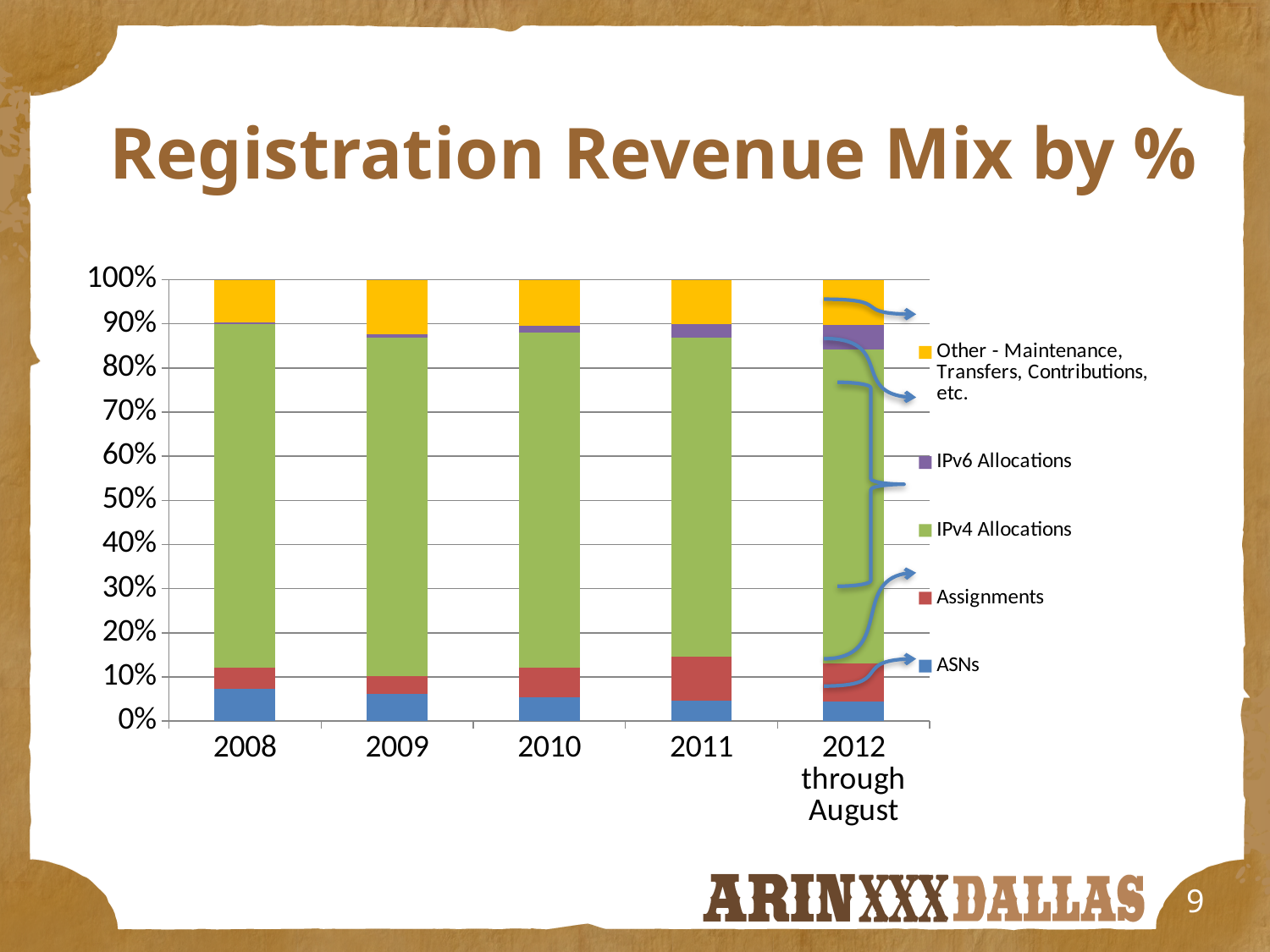
Which year has the largest IPv6 Allocations share? 2012 through August Is the ASNs share in 2008 greater or less than 10%? less How many years (categories) are shown on the x axis? 5 Which series is shown in green in the legend? IPv4 Allocations Is the IPv6 Allocations share larger in 2008 or in 2012 through August? 2012 through August Which series makes up the largest share of the bar in every year? IPv4 Allocations Is the IPv6 Allocations share in 2012 through August greater or less than 10%? less How many series does the legend list? 5 Does the ASNs share rise or fall from 2008 to 2012 through August? fall What kind of chart is shown on the slide? Stacked bar chart Is the IPv4 Allocations share in 2012 through August greater or less than 60%? greater What is the title of the chart on the slide? Registration Revenue Mix by %